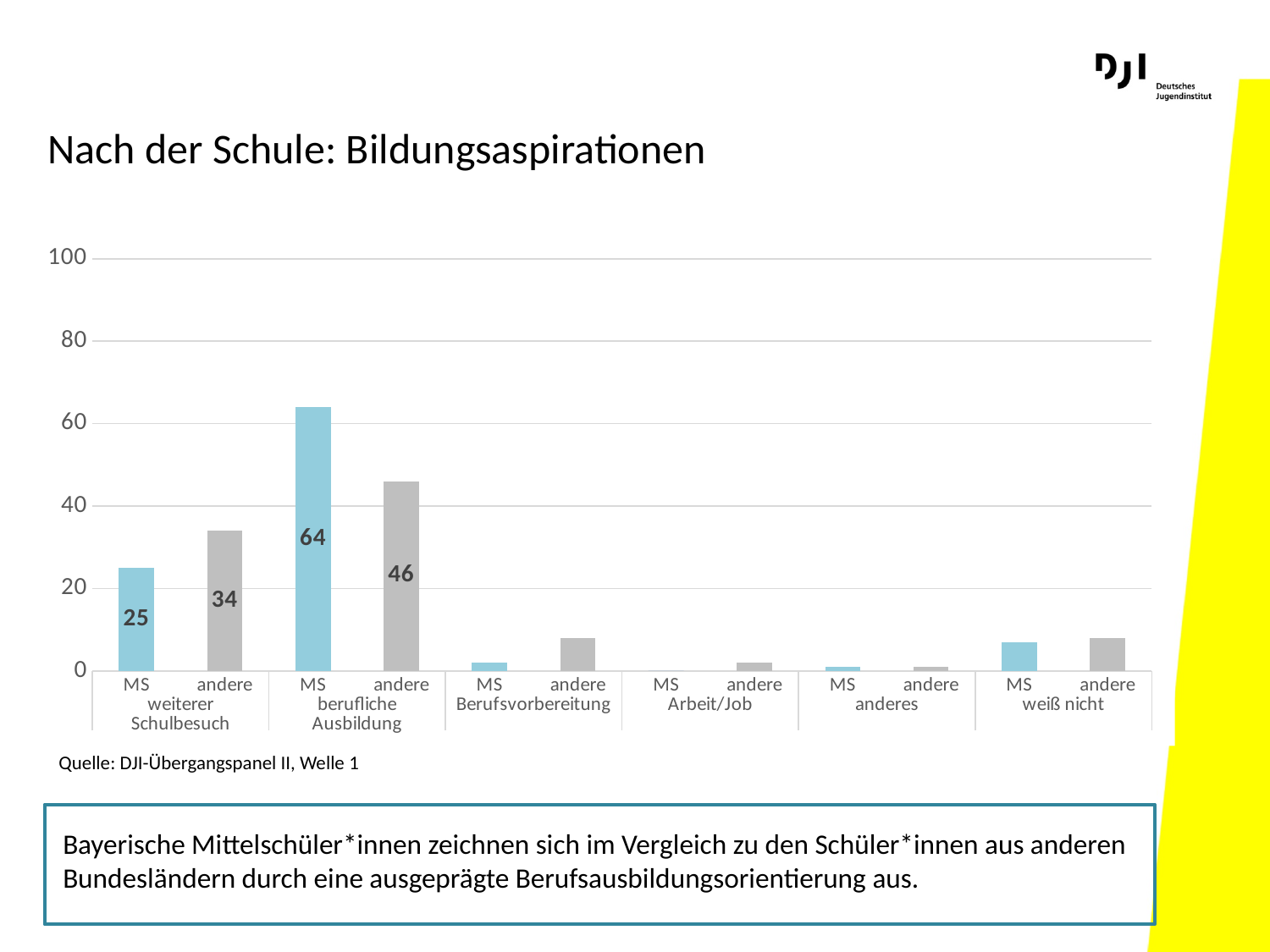
What is the difference between the MS and 'andere' values in the 'berufliche Ausbildung' group? 18 What is the title of the slide containing the chart? Nach der Schule: Bildungsaspirationen What is the value for 'andere' in the 'weiterer Schulbesuch' group? 34 What is the value for MS in the 'weiterer Schulbesuch' group? 25 What kind of chart is shown on the slide? bar chart What is the value for MS in the 'berufliche Ausbildung' group? 64 Is the value for 'andere' in the 'Berufsvorbereitung' group greater or less than 20? less What is the difference between the 'andere' and MS values in the 'weiterer Schulbesuch' group? 9 Which bar has the highest value in the chart? MS, berufliche Ausbildung What is the value for 'andere' in the 'berufliche Ausbildung' group? 46 In the 'weiterer Schulbesuch' group, which is larger: MS or 'andere'? andere How many category groups are shown on the x axis? 6